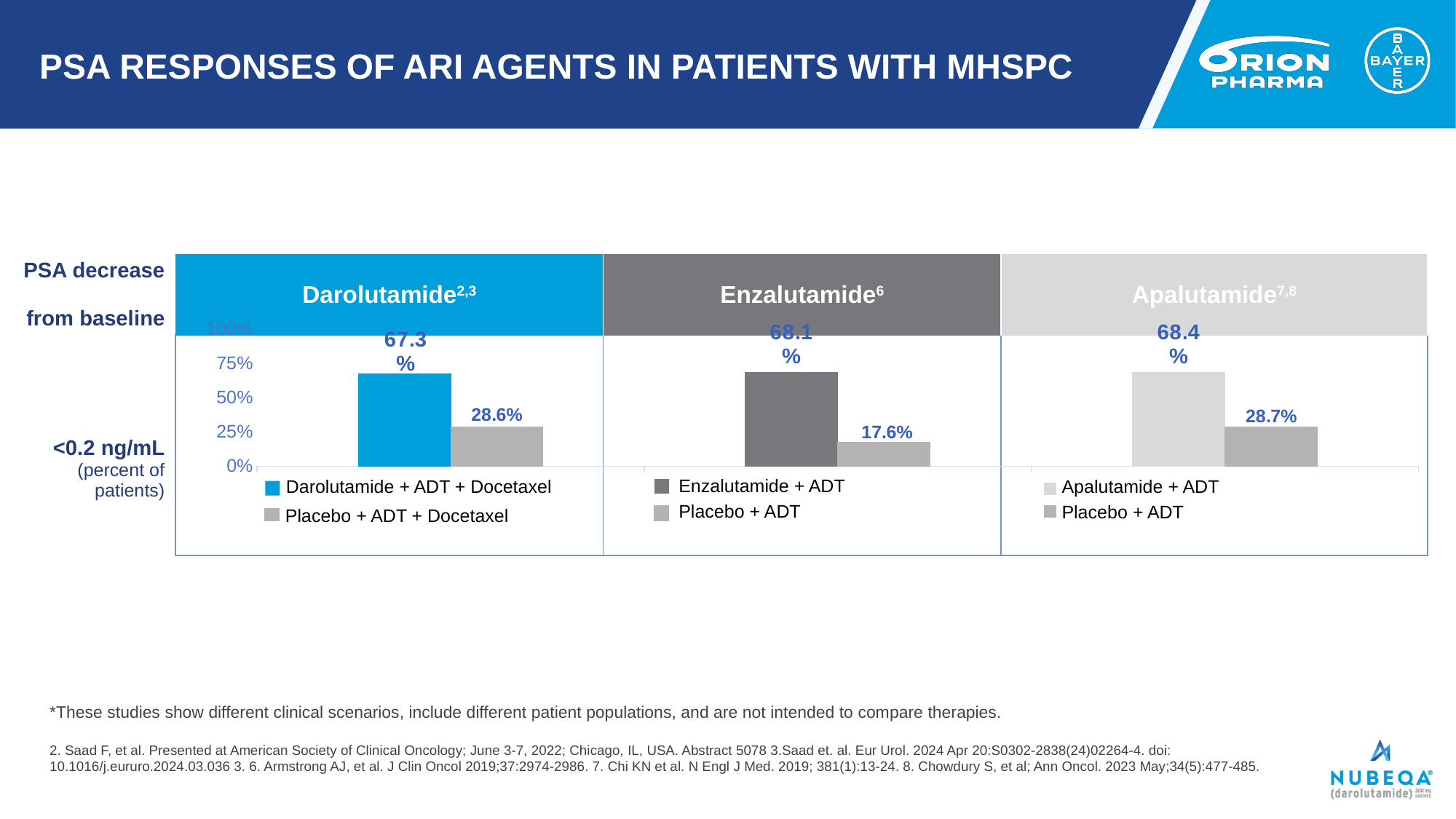
What type of chart is used in the Enzalutamide panel? Bar chart In the Apalutamide chart, what is the value for Placebo + ADT? 28.7% In the Darolutamide chart, what is the value for Placebo + ADT + Docetaxel? 28.6% How many series does the legend of the Darolutamide chart list? 2 In the Apalutamide chart, what is the value for Apalutamide + ADT? 68.4% In the Enzalutamide chart, what is the value for Enzalutamide + ADT? 68.1% In the Darolutamide chart, what is the difference between the Darolutamide + ADT + Docetaxel value and the Placebo + ADT + Docetaxel value? 38.7% In the Apalutamide chart, which bar is higher: Apalutamide + ADT or Placebo + ADT? Apalutamide + ADT In the Enzalutamide chart, what is the difference between the Enzalutamide + ADT value and the Placebo + ADT value? 50.5% In the Darolutamide chart, is the value for Placebo + ADT + Docetaxel greater or less than 50%? less In the Enzalutamide chart, what is the value for Placebo + ADT? 17.6% In the Darolutamide chart, what percentage of patients had a PSA decrease to <0.2 ng/mL with Darolutamide + ADT + Docetaxel? 67.3%